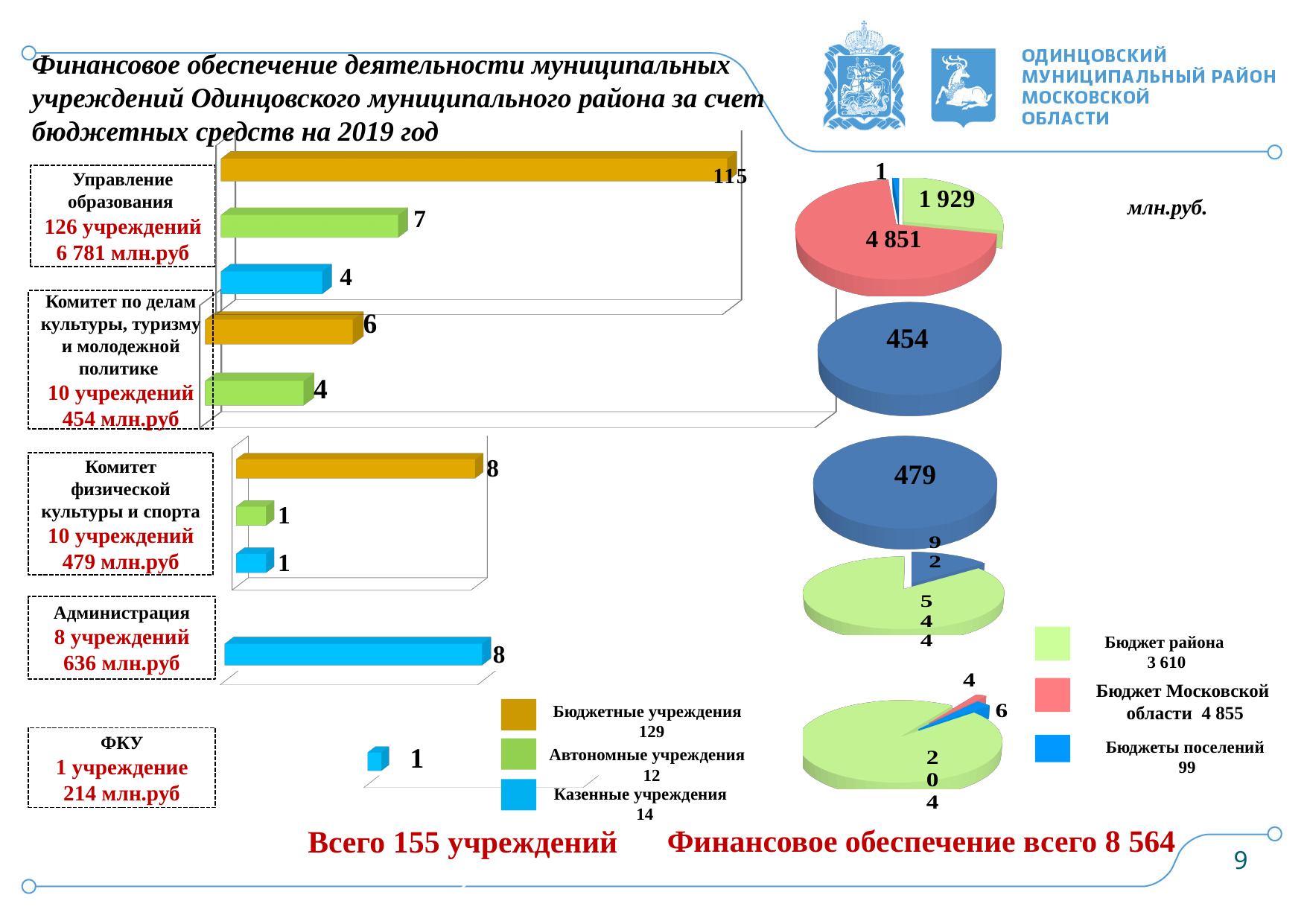
In the pie chart for Управление образования, which slice is the largest? Бюджет Московской области In the bar chart for Управление образования, what is the value for Казенные учреждения? 4 In the pie chart for Управление образования, what is the value for Бюджет Московской области? 4 851 In the bar chart for Управление образования, what is the difference between Бюджетные учреждения and Автономные учреждения? 108 In the pie chart for Администрация, what is the value for Бюджет района? 544 What kind of chart is used on the left side of the slide to show the number of institutions per department? bar chart In the bar chart for Управление образования, which category has the highest value? Бюджетные учреждения In the bar chart for Комитет по делам культуры, туризму и молодежной политике, what is the value for Автономные учреждения? 4 How many series does the legend of the bar charts list? 3 In the bar chart for Управление образования, what is the value for Бюджетные учреждения? 115 In the bar chart for Администрация, what is the value for Казенные учреждения? 8 In the bar chart for Комитет физической культуры и спорта, which is larger: Бюджетные учреждения or Автономные учреждения? Бюджетные учреждения